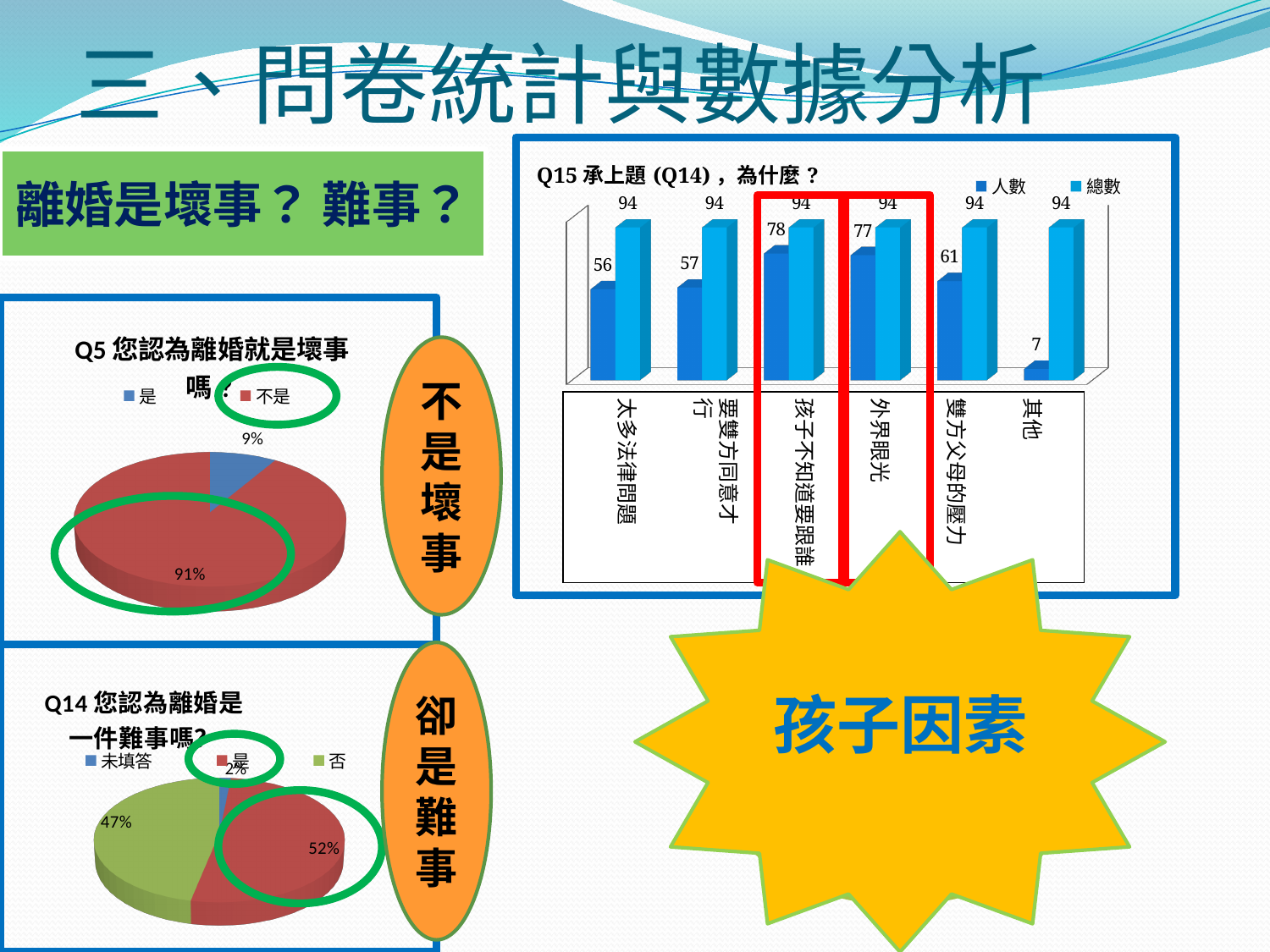
In the Q14 pie chart, what share of the pie is 否? 47% How many categories are shown in the Q15 bar chart? 6 In the Q14 pie chart, which slice is the largest? 是 In the Q15 bar chart, which category has the lowest 人數 value? 其他 In the Q15 bar chart, what is the 人數 value for 孩子不知道要跟誰? 78 In the Q15 bar chart, which has a larger 人數 value, 外界眼光 or 雙方父母的壓力? 外界眼光 In the Q15 bar chart, what is the 人數 value for 其他? 7 In the Q15 bar chart, which category has the highest 人數 value? 孩子不知道要跟誰 What kind of chart is the Q15 chart? bar chart In the Q5 pie chart, what share of the pie is 不是? 91% In the Q15 bar chart, what is the difference between the 人數 values for 雙方父母的壓力 and 太多法律問題? 5 How many series does the legend of the Q15 chart list? 2